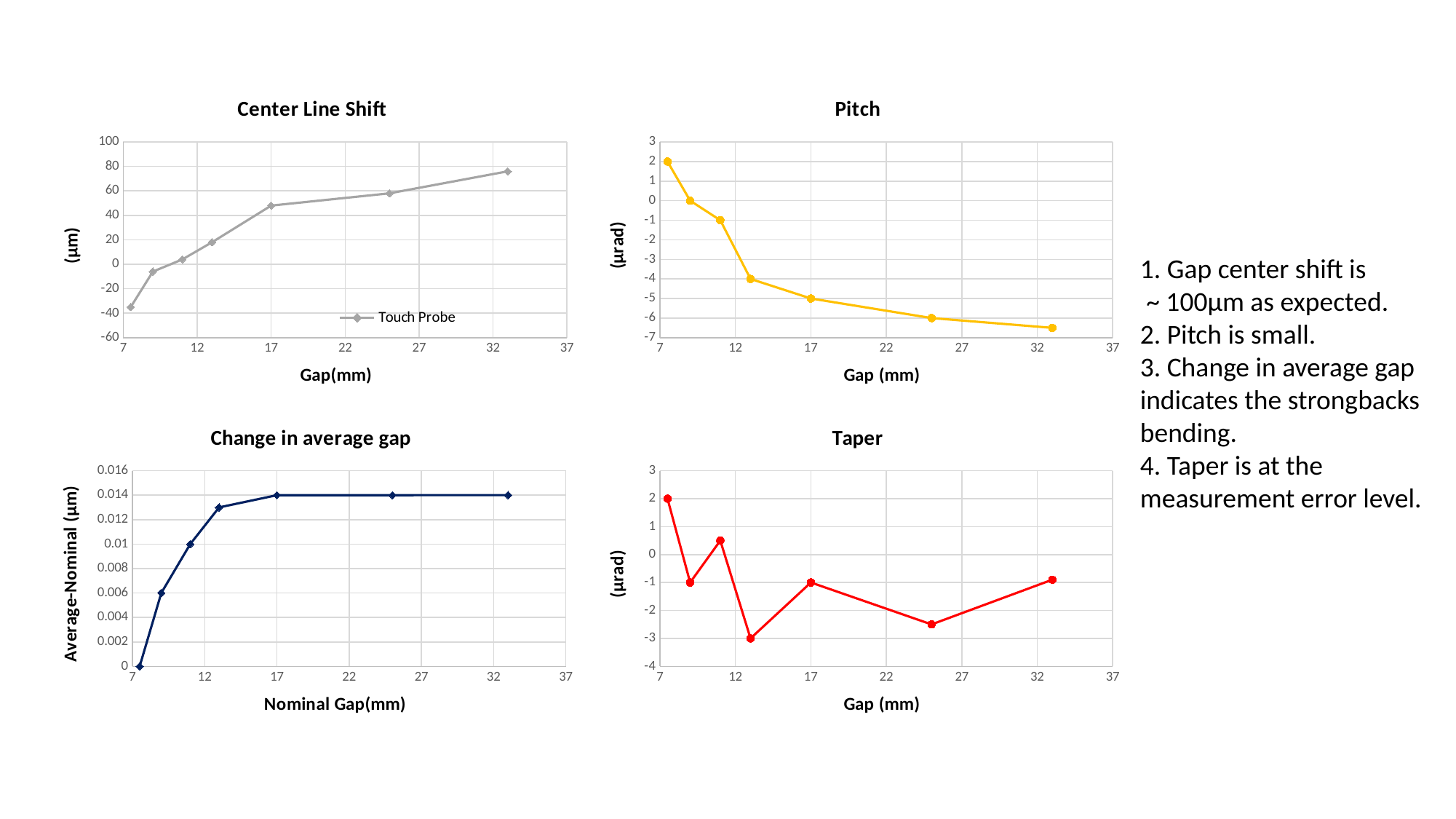
In the "Pitch" chart, what is the value at a gap of 17 mm? -5 What series name does the legend of the "Center Line Shift" chart show? Touch Probe In the "Change in average gap" chart, what is the value at a nominal gap of 17 mm? 0.014 In the "Center Line Shift" chart, do the values rise or fall as the gap increases? rise In the "Pitch" chart, what is the value at a gap of 9 mm? 0 In the "Taper" chart, what is the value at a gap of 17 mm? -1 In the "Center Line Shift" chart, is the value at a gap of 33 mm greater or less than 60? greater How many data points are plotted in the "Pitch" chart? 7 What kind of chart is the "Center Line Shift" chart? line chart In the "Pitch" chart, do the values rise or fall as the gap increases? fall What is the y-axis label of the "Change in average gap" chart? Average-Nominal (µm)